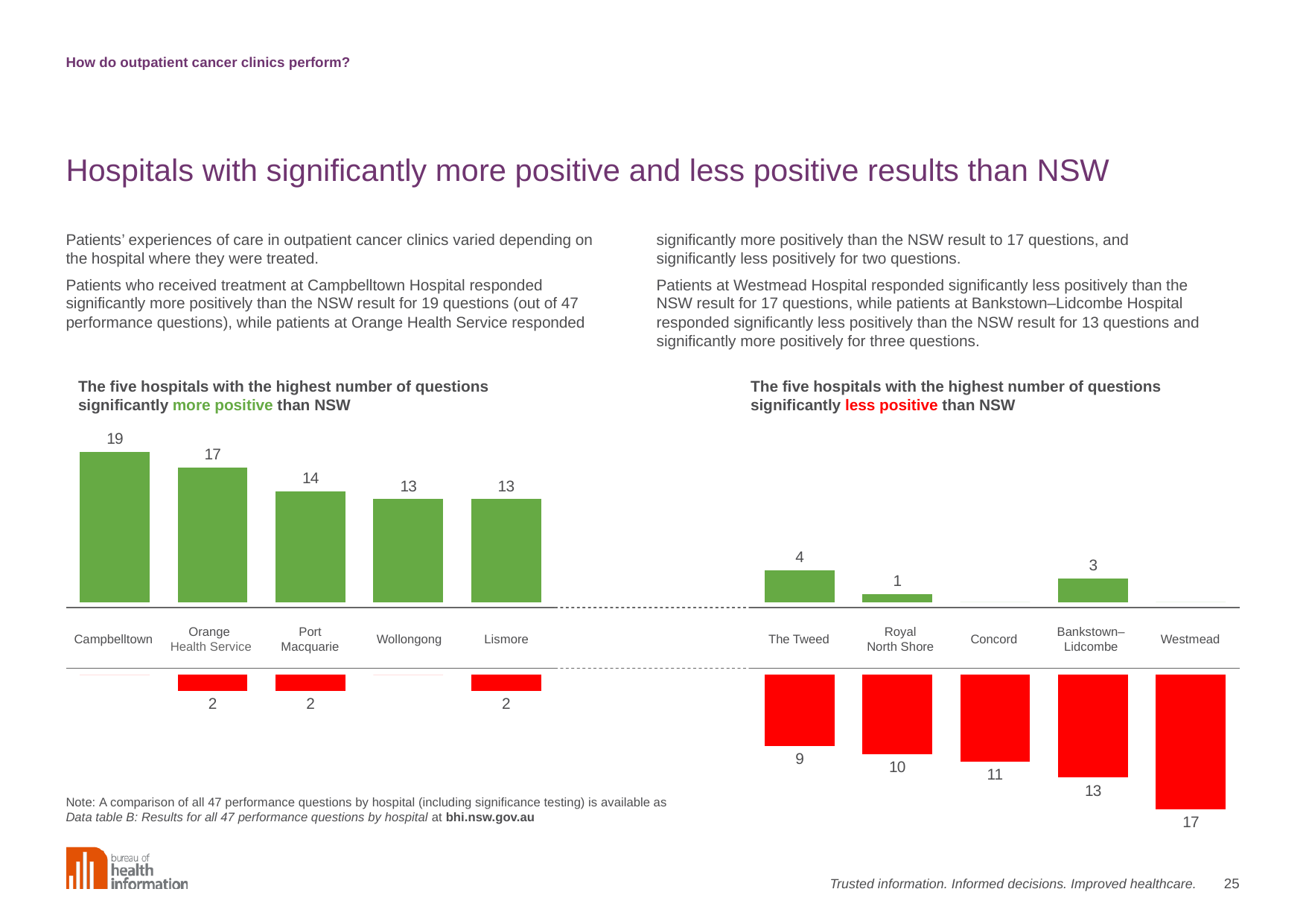
In the chart 'The five hospitals with the highest number of questions significantly less positive than NSW', which hospital has the lowest number of significantly less positive questions? The Tweed What type of chart is used on this slide to show the number of questions by hospital? Bar chart In the chart 'The five hospitals with the highest number of questions significantly more positive than NSW', what is the difference between the number of more positive questions for Campbelltown and Orange Health Service? 2 In the chart 'The five hospitals with the highest number of questions significantly more positive than NSW', how many questions were significantly less positive for Lismore? 2 In the chart 'The five hospitals with the highest number of questions significantly more positive than NSW', how many questions were significantly more positive for Port Macquarie? 14 In the chart 'The five hospitals with the highest number of questions significantly less positive than NSW', which has more significantly less positive questions, Concord or Bankstown–Lidcombe? Bankstown–Lidcombe In the chart 'The five hospitals with the highest number of questions significantly more positive than NSW', how many questions were significantly more positive for Campbelltown? 19 In the chart 'The five hospitals with the highest number of questions significantly less positive than NSW', what is the difference between the number of less positive questions for Westmead and Royal North Shore? 7 How many hospitals are shown in the chart 'The five hospitals with the highest number of questions significantly more positive than NSW'? 5 In the chart 'The five hospitals with the highest number of questions significantly less positive than NSW', how many questions were significantly more positive for The Tweed? 4 In the chart 'The five hospitals with the highest number of questions significantly less positive than NSW', how many questions were significantly less positive for Westmead? 17 In the chart 'The five hospitals with the highest number of questions significantly more positive than NSW', which hospital has the highest number of significantly more positive questions? Campbelltown